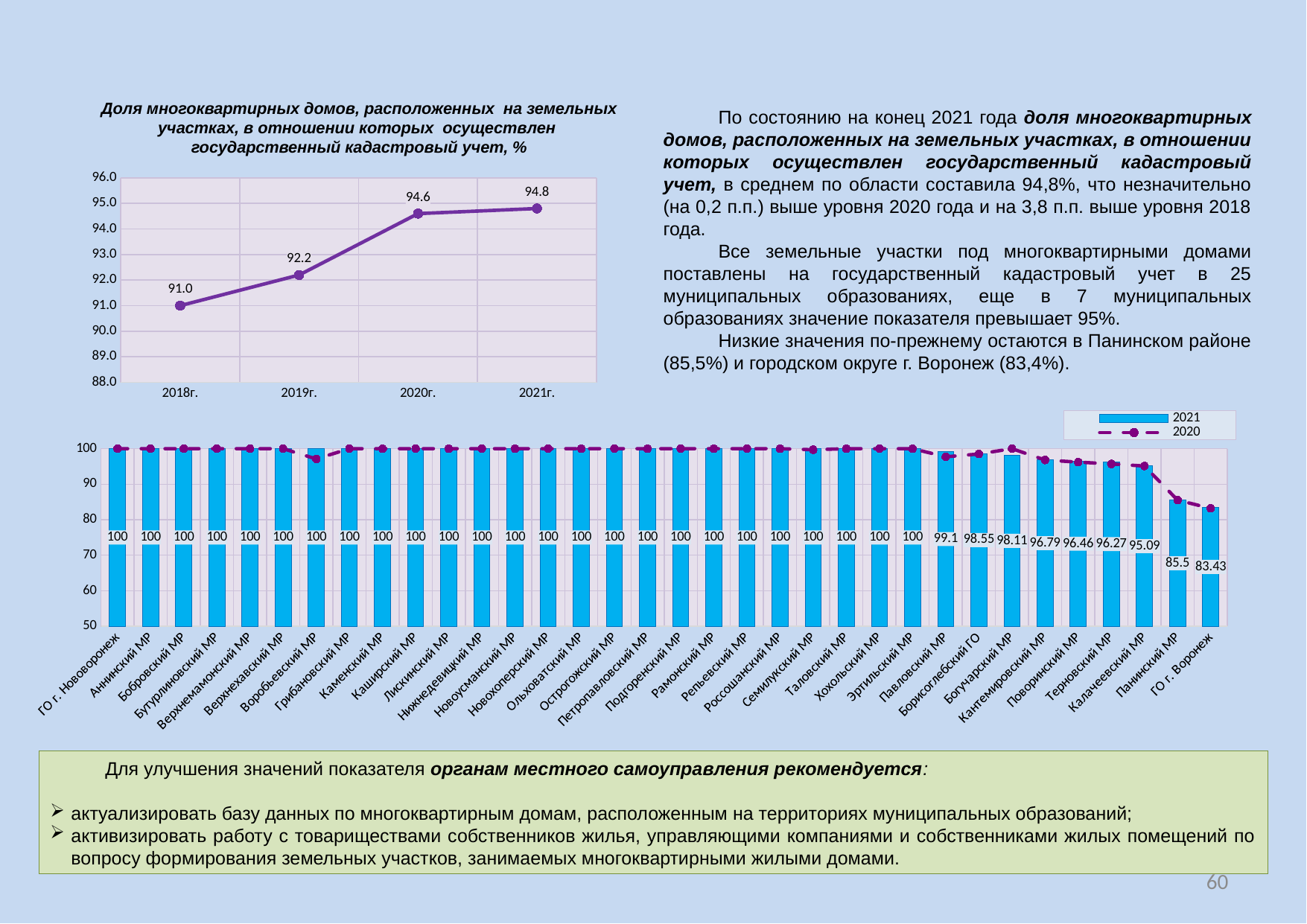
In the top-left line chart, which year has the lowest value? 2018г. What kind of chart is the top-left chart? line chart In the top-left line chart, what is the value for 2018г.? 91.0 In the top-left line chart, do the values rise or fall from 2018г. to 2021г.? rise In the bottom bar chart, what is the 2021 value for Панинский МР? 85.5 In the bottom bar chart, which is larger for 2021: Павловский МР or Богучарский МР? Павловский МР In the bottom bar chart, what is the difference between the 2021 values for Панинский МР and ГО г. Воронеж? 2.07 In the bottom bar chart, which category has the lowest 2021 value? ГО г. Воронеж In the bottom bar chart, what is the 2021 value for Кантемировский МР? 96.79 In the top-left line chart, what is the value for 2021г.? 94.8 In the bottom bar chart, how many series does the legend list? 2 In the top-left line chart, what is the difference between the 2020г. and 2019г. values? 2.4